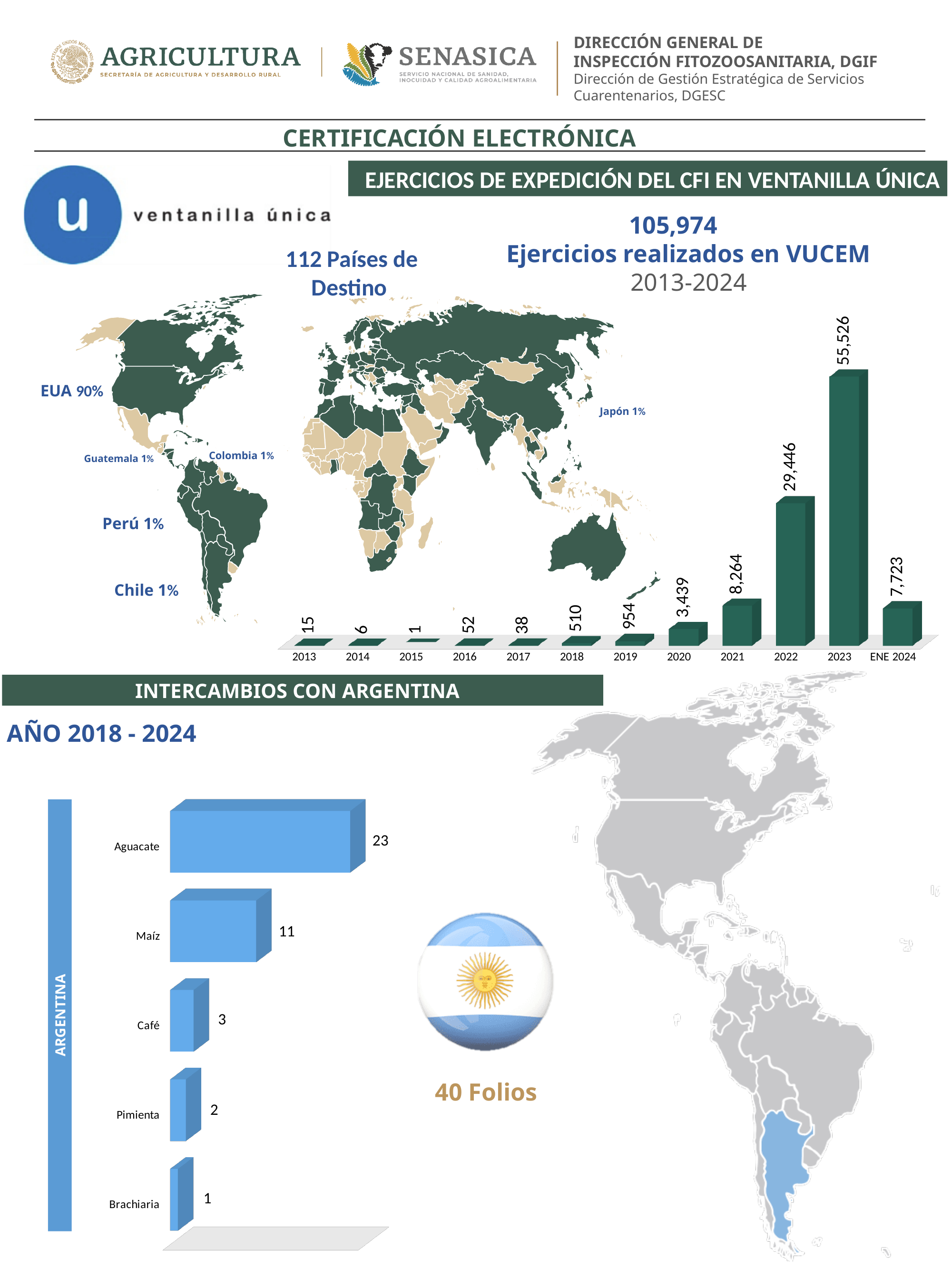
In the 'Ejercicios realizados en VUCEM' bar chart at the top right, what is the difference between the values for 2023 and 2022? 26,080 How many categories are shown in the 'Intercambios con Argentina' bar chart at the bottom left? 5 How many bars are shown in the 'Ejercicios realizados en VUCEM' bar chart at the top right? 12 In the 'Intercambios con Argentina' bar chart at the bottom left, what is the difference between the values for Aguacate and Café? 20 In the 'Ejercicios realizados en VUCEM' bar chart at the top right, what is the value for 2023? 55,526 In the 'Ejercicios realizados en VUCEM' bar chart at the top right, which is larger, the value for 2021 or the value for ENE 2024? 2021 What type of chart is used for 'Ejercicios realizados en VUCEM' at the top right of the slide? Bar chart In the 'Intercambios con Argentina' bar chart at the bottom left, what is the value for Maíz? 11 In the 'Ejercicios realizados en VUCEM' bar chart at the top right, which year has the highest value? 2023 In the 'Ejercicios realizados en VUCEM' bar chart at the top right, which year has the lowest value? 2015 In the 'Intercambios con Argentina' bar chart at the bottom left, which category has the highest value? Aguacate In the 'Ejercicios realizados en VUCEM' bar chart at the top right, what is the value for 2020? 3,439